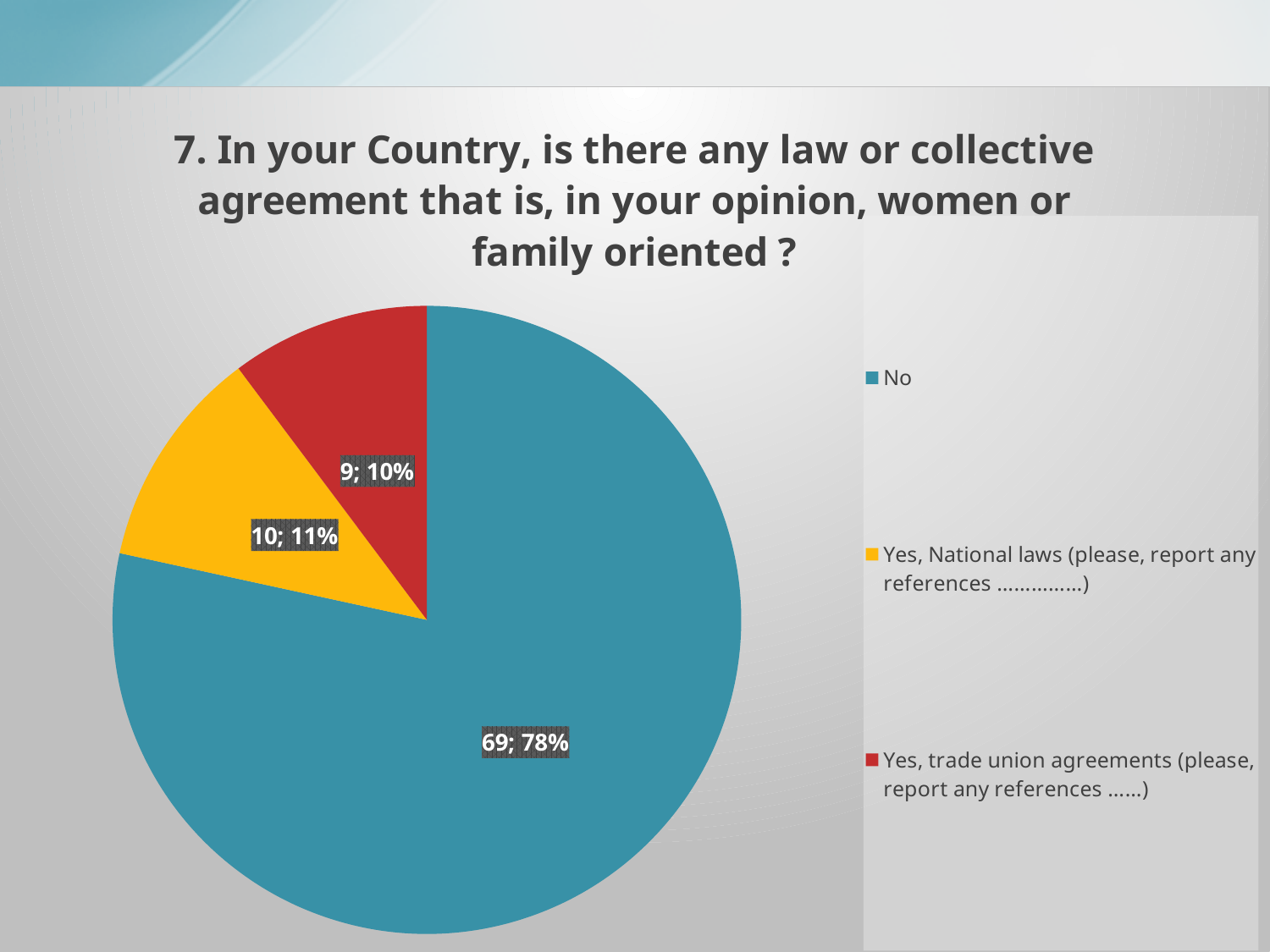
How many entries does the legend list? 3 What kind of chart is shown on the slide? pie chart How many slices does the pie chart have? 3 Which colour represents the "No" category in the pie chart? blue Which category has the largest slice? No What percentage share does the "Yes, trade union agreements" slice have? 10% What is the difference in count between the "No" slice and the "Yes, National laws" slice? 59 What percentage share does the "No" slice have? 78% What is the count shown for the "Yes, National laws" slice? 10 What is the count shown for the "No" slice? 69 What is the count shown for the "Yes, trade union agreements" slice? 9 What percentage share does the "Yes, National laws" slice have? 11%